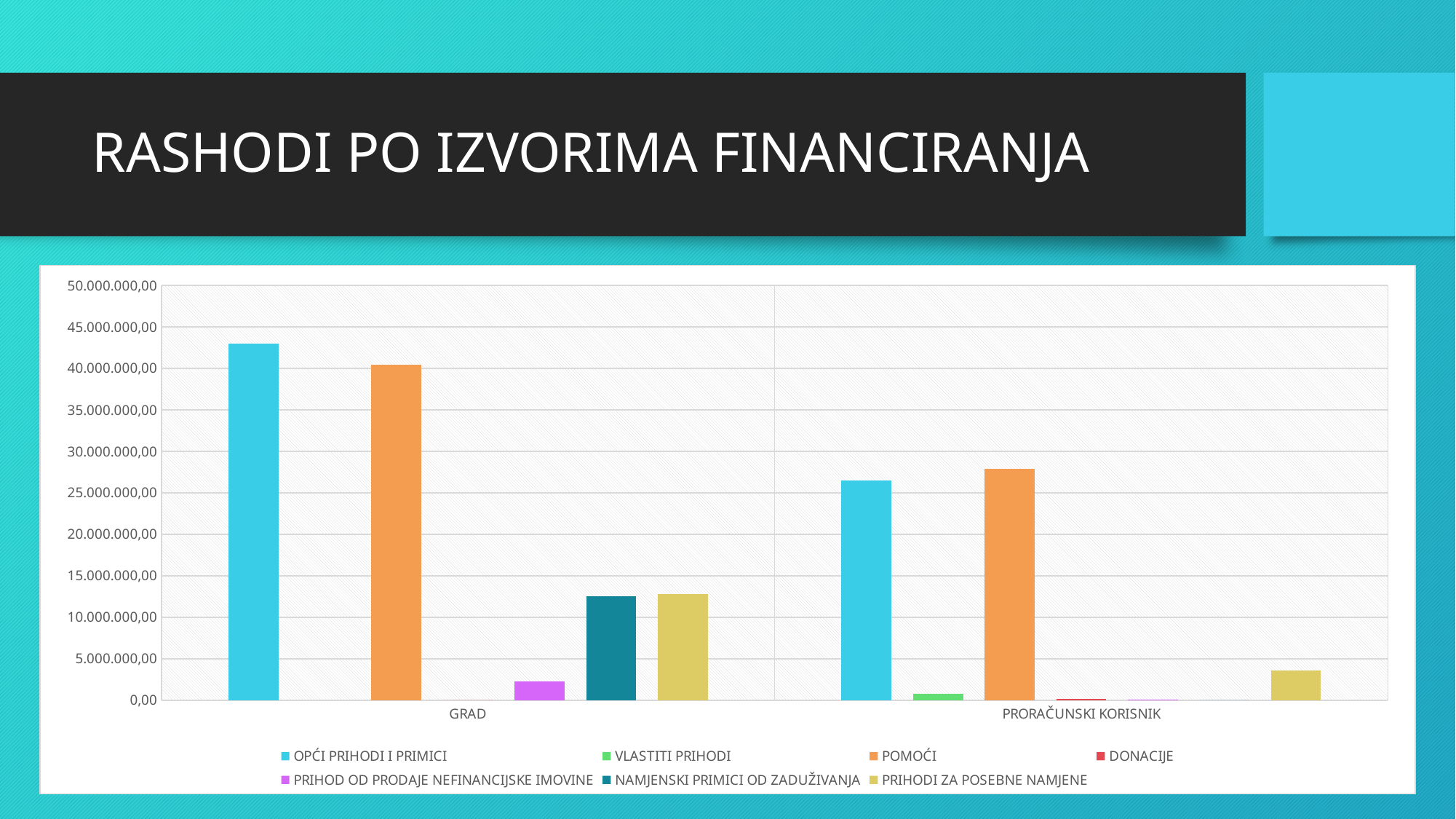
Which series has the highest value for GRAD? OPĆI PRIHODI I PRIMICI What is the title of the slide containing the chart? RASHODI PO IZVORIMA FINANCIRANJA How many categories are shown on the x axis of the chart? 2 Which series has the highest value for PRORAČUNSKI KORISNIK? POMOĆI Which is larger for OPĆI PRIHODI I PRIMICI: the value for GRAD or the value for PRORAČUNSKI KORISNIK? GRAD What kind of chart is shown on the slide? bar chart How many series does the chart's legend list? 7 Is the value of OPĆI PRIHODI I PRIMICI for GRAD greater or less than 40.000.000,00? greater Is the value of POMOĆI for GRAD greater or less than 45.000.000,00? less Is the value of PRIHODI ZA POSEBNE NAMJENE for PRORAČUNSKI KORISNIK greater or less than 5.000.000,00? less